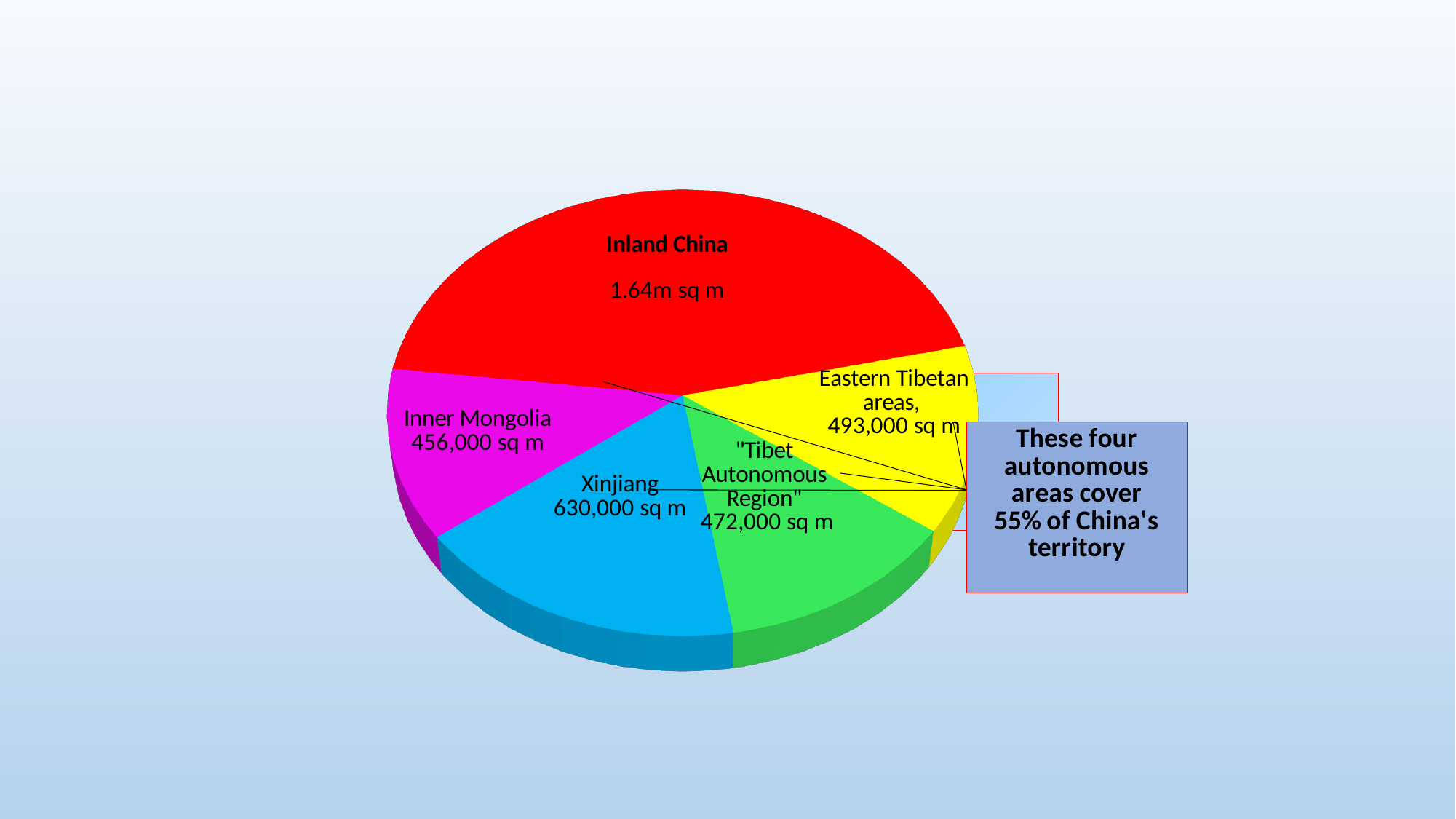
What value is shown for the "Tibet Autonomous Region" slice? 472,000 sq m What is the difference between the values for Xinjiang and Inner Mongolia? 174,000 sq m What value is shown for Xinjiang? 630,000 sq m How many slices does the pie chart have? 5 What value is shown for Inland China? 1.64m sq m What value is shown for Inner Mongolia? 456,000 sq m Which is larger, the value for Xinjiang or the value for Eastern Tibetan areas? Xinjiang Which slice of the pie chart is the largest? Inland China Which slice of the pie chart has the smallest value? Inner Mongolia What kind of chart is shown on the slide? Pie chart What value is shown for Eastern Tibetan areas? 493,000 sq m According to the text box next to the chart, what share of China's territory do the four autonomous areas cover? 55%